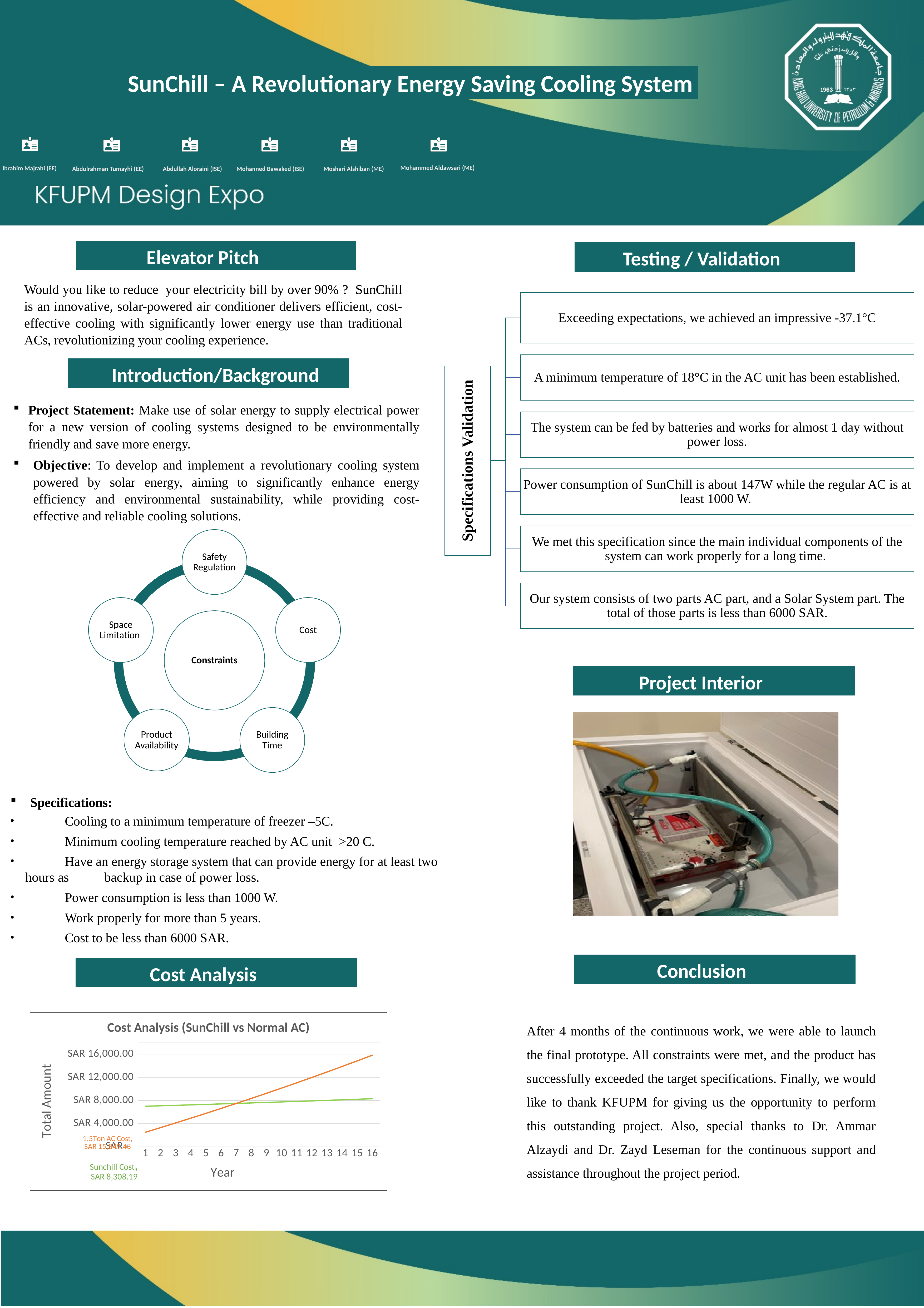
What kind of chart is the Cost Analysis (SunChill vs Normal AC) chart? line chart What is the label of the x axis on the Cost Analysis (SunChill vs Normal AC) chart? Year In the Cost Analysis (SunChill vs Normal AC) chart, is the 1.5Ton AC Cost at year 1 greater or less than SAR 4,000.00? less How many series does the Cost Analysis (SunChill vs Normal AC) chart plot? 2 In the Cost Analysis (SunChill vs Normal AC) chart, does the 1.5Ton AC Cost rise or fall as the years increase? rise What is the label of the y axis on the Cost Analysis (SunChill vs Normal AC) chart? Total Amount In the Cost Analysis (SunChill vs Normal AC) chart, what is the labelled value of the Sunchill Cost series at the end of the line? SAR 8,308.19 In the Cost Analysis (SunChill vs Normal AC) chart, is the Sunchill Cost at year 1 greater or less than SAR 8,000.00? less In the Cost Analysis (SunChill vs Normal AC) chart, which series has the higher cost at year 1? Sunchill Cost In the Cost Analysis (SunChill vs Normal AC) chart, which series has the higher cost at year 16? 1.5Ton AC Cost In the Cost Analysis (SunChill vs Normal AC) chart, is the 1.5Ton AC Cost at year 16 greater or less than SAR 12,000.00? greater How many years are shown on the x axis of the Cost Analysis (SunChill vs Normal AC) chart? 16